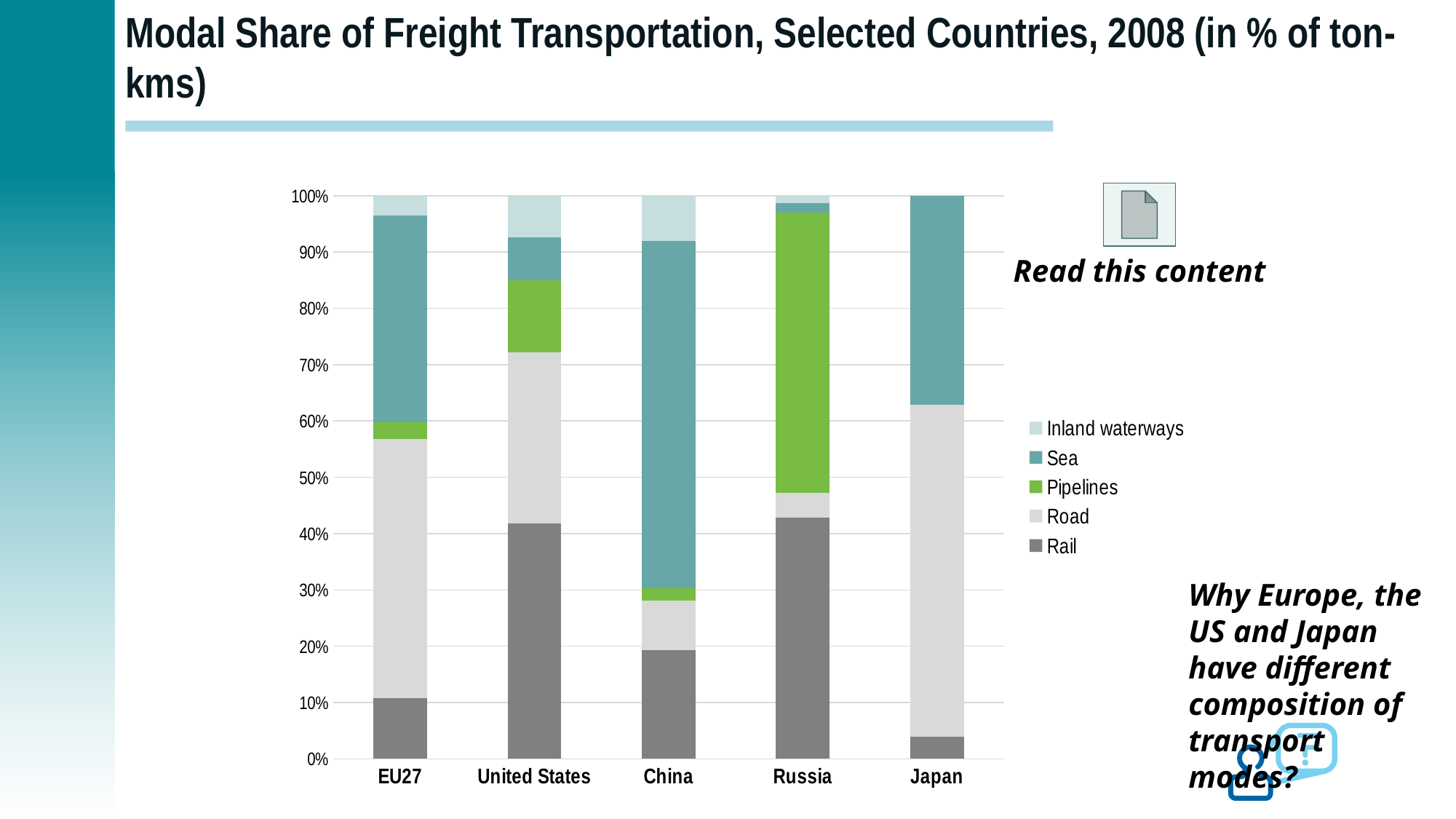
Which country has the largest Sea share? China Is the Sea share for China greater or less than 50%? greater How many countries are shown on the x axis of the chart? 5 Which country has the smallest Rail share? Japan Which country has the largest Road share? Japan Which has the larger Rail share, the United States or EU27? United States What is the title of the chart on the slide? Modal Share of Freight Transportation, Selected Countries, 2008 (in % of ton-kms) Is the Rail share for the United States greater or less than 40%? greater What kind of chart is shown on the slide? Stacked bar chart Which country has the largest Pipelines share? Russia How many series does the chart's legend list? 5 Is the Rail share for Japan greater or less than 10%? less